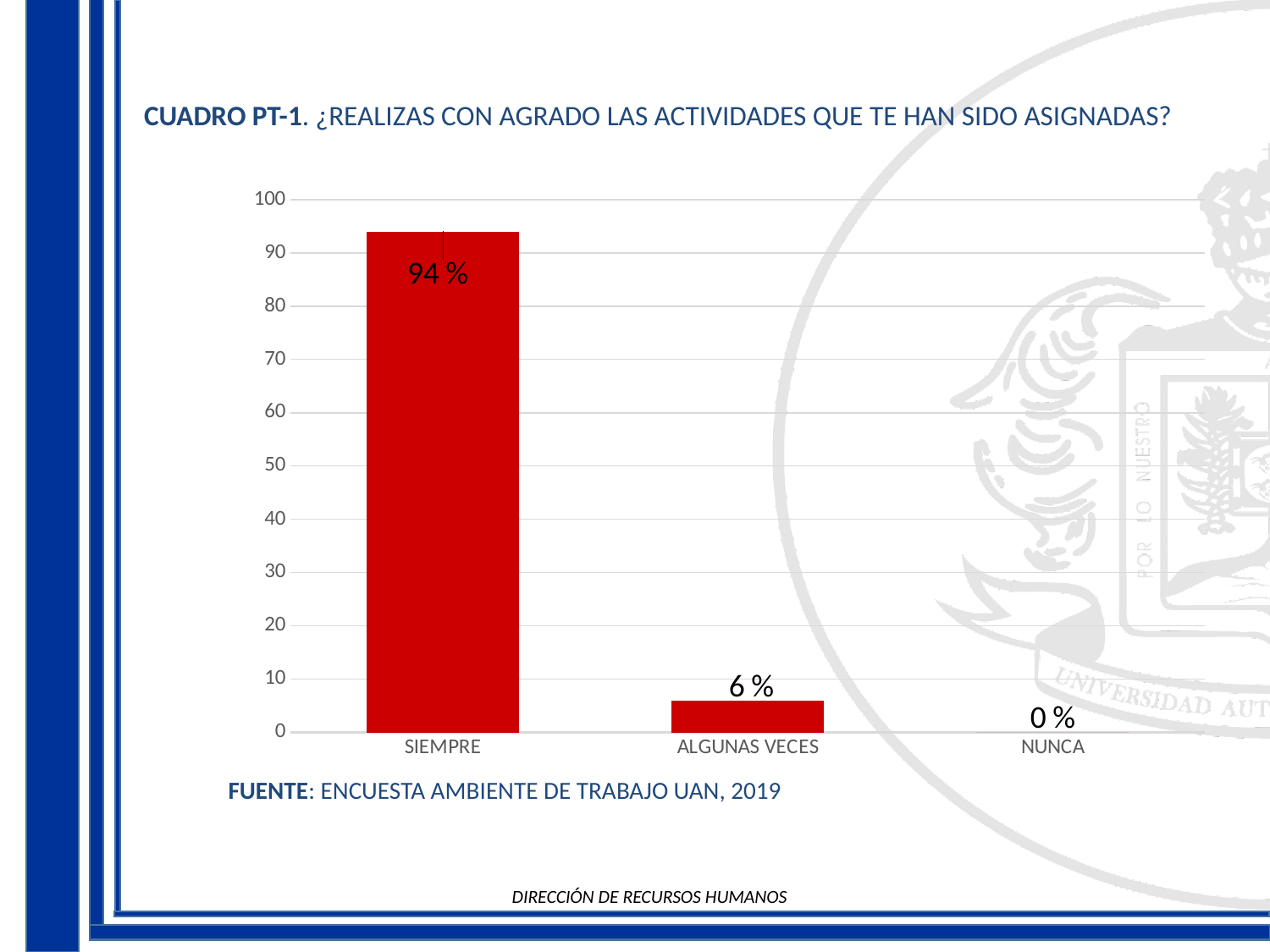
What is the value for NUNCA? 0 % Is the value for ALGUNAS VECES greater or less than 10? less Which is larger, the value for ALGUNAS VECES or the value for NUNCA? ALGUNAS VECES Which category has the lowest value? NUNCA What kind of chart is shown on the slide? bar chart How many categories are shown on the x axis? 3 Is the value for SIEMPRE greater or less than 90? greater What is the value for SIEMPRE? 94 % What is the difference between the values for SIEMPRE and ALGUNAS VECES? 88 % What is the source cited below the chart? ENCUESTA AMBIENTE DE TRABAJO UAN, 2019 Which category has the highest value? SIEMPRE What is the value for ALGUNAS VECES? 6 %